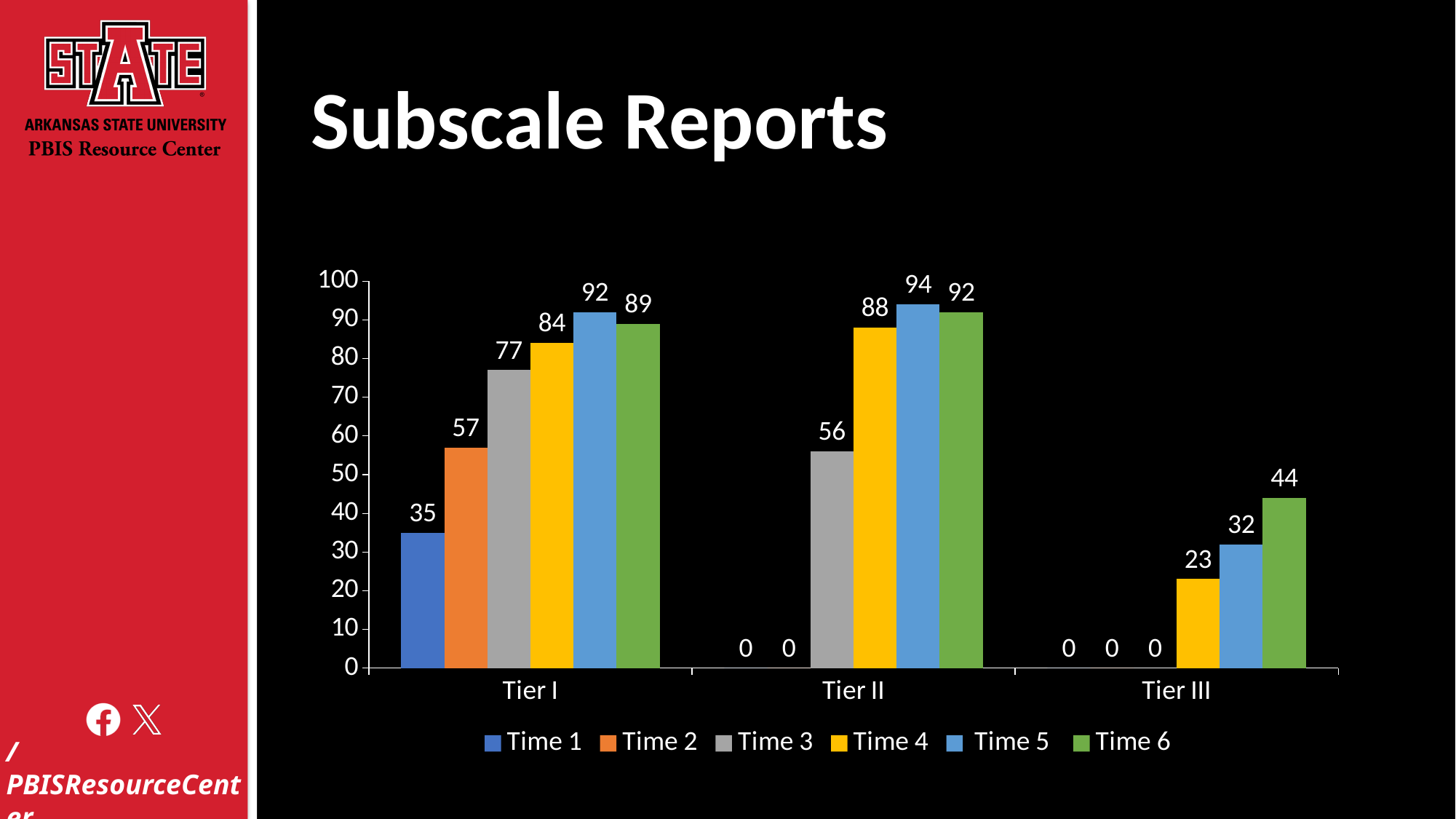
How many series does the legend list? 6 What is the value for Time 5 in Tier II? 94 What is the value for Time 4 in Tier III? 23 What is the difference between Time 2 and Time 1 in Tier I? 22 How many categories are shown on the x axis? 3 What kind of chart is shown on the slide? Bar chart What is the value for Time 1 in Tier I? 35 What is the value for Time 6 in Tier III? 44 Which time point has the lowest non-zero value in Tier III? Time 4 What is the difference between the Time 6 values for Tier I and Tier II? 3 Which is larger: Time 3 in Tier I or Time 3 in Tier II? Time 3 in Tier I Which time point has the highest value in Tier I? Time 5